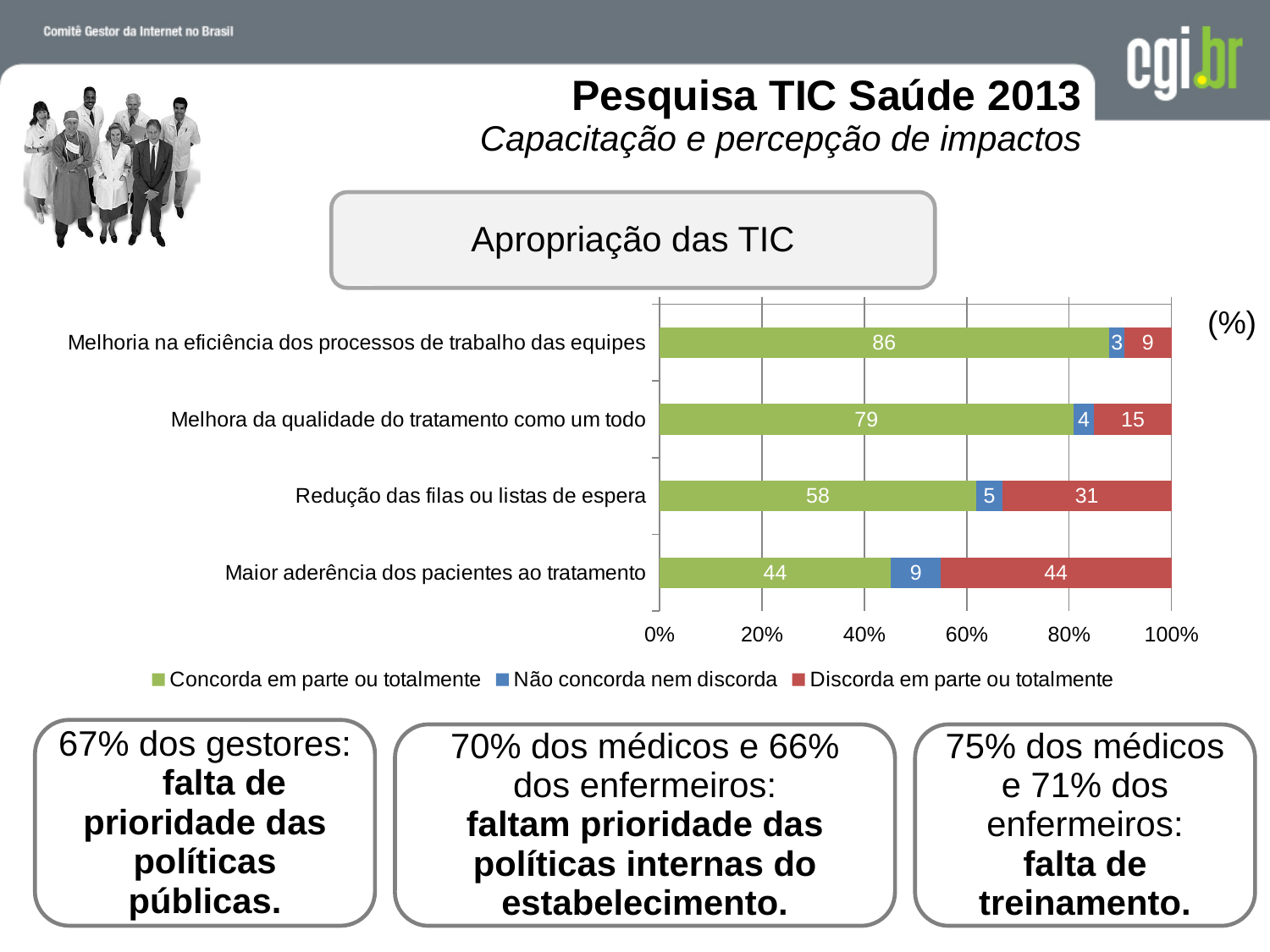
Which colour represents 'Discorda em parte ou totalmente' in the chart? Red What percentage of respondents agree in part or totally (Concorda em parte ou totalmente) that ICT brought 'Melhoria na eficiência dos processos de trabalho das equipes'? 86 Which category has the highest value for 'Concorda em parte ou totalmente'? Melhoria na eficiência dos processos de trabalho das equipes What is the value for 'Não concorda nem discorda' for 'Maior aderência dos pacientes ao tratamento'? 9 Which is larger: the 'Discorda em parte ou totalmente' value for 'Redução das filas ou listas de espera' or for 'Melhora da qualidade do tratamento como um todo'? Redução das filas ou listas de espera What is the value for 'Discorda em parte ou totalmente' for 'Melhora da qualidade do tratamento como um todo'? 15 How many categories are shown in the chart? 4 How many series does the legend list? 3 What is the difference between the 'Concorda em parte ou totalmente' values for 'Melhoria na eficiência dos processos de trabalho das equipes' and 'Redução das filas ou listas de espera'? 28 Which category has the lowest value for 'Concorda em parte ou totalmente'? Maior aderência dos pacientes ao tratamento What is the value for 'Discorda em parte ou totalmente' for 'Redução das filas ou listas de espera'? 31 What kind of chart is shown on the slide? Stacked bar chart